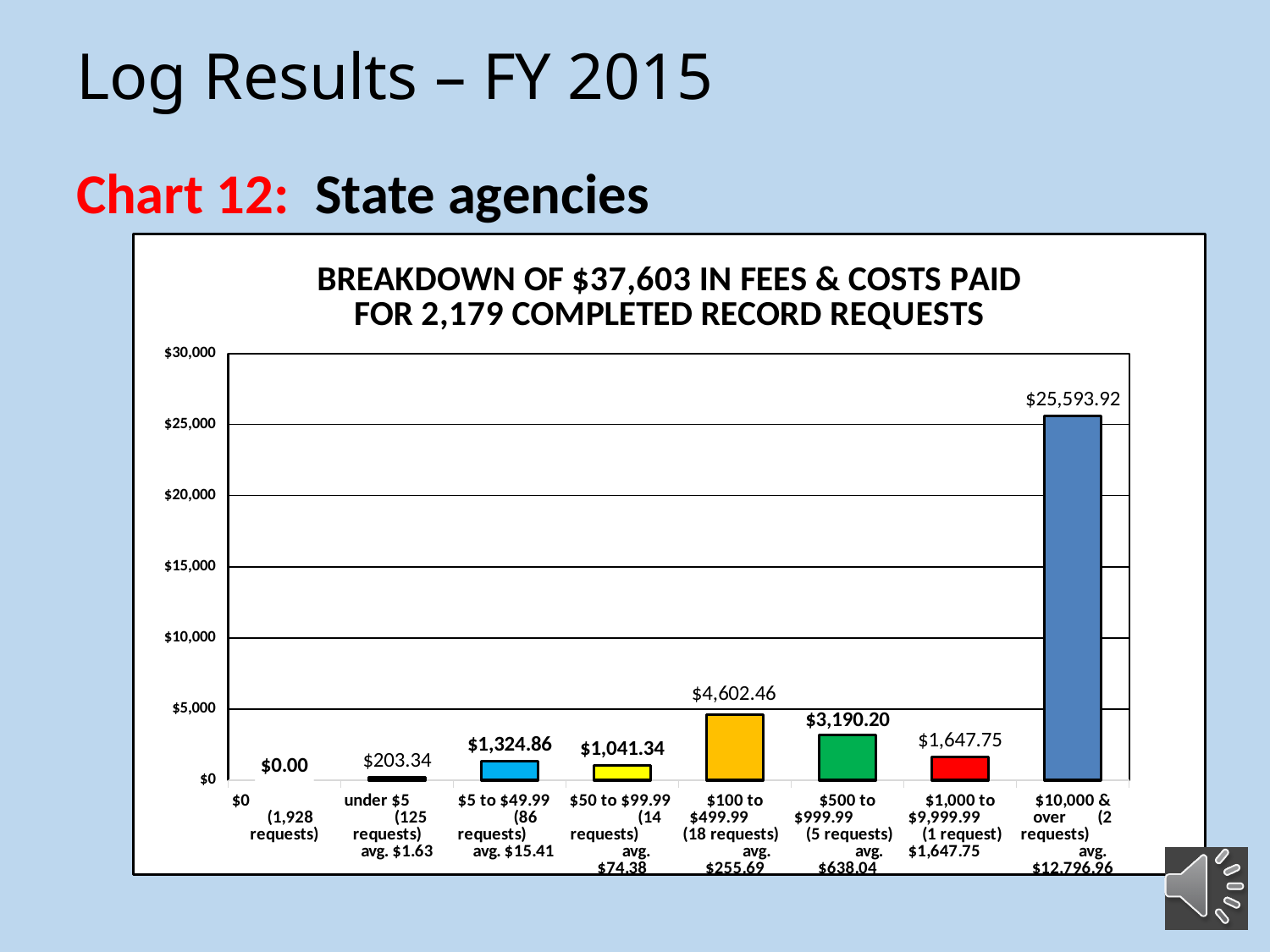
Which is larger, the value for "$500 to $999.99" or the value for "$1,000 to $9,999.99"? $500 to $999.99 What is the value of the bar for the "$10,000 & over" category? $25,593.92 Is the value for "$10,000 & over" greater or less than $25,000? greater Which category has the highest value? $10,000 & over What is the difference between the values for "$100 to $499.99" and "$500 to $999.99"? $1,412.26 How many categories are shown on the x axis? 8 What is the title of the chart? BREAKDOWN OF $37,603 IN FEES & COSTS PAID FOR 2,179 COMPLETED RECORD REQUESTS What kind of chart is shown on the slide? bar chart What is the value of the bar for the "$500 to $999.99" category? $3,190.20 What is the value of the bar for the "$100 to $499.99" category? $4,602.46 Which category has the lowest value? $0 What is the value of the bar for the "under $5" category? $203.34